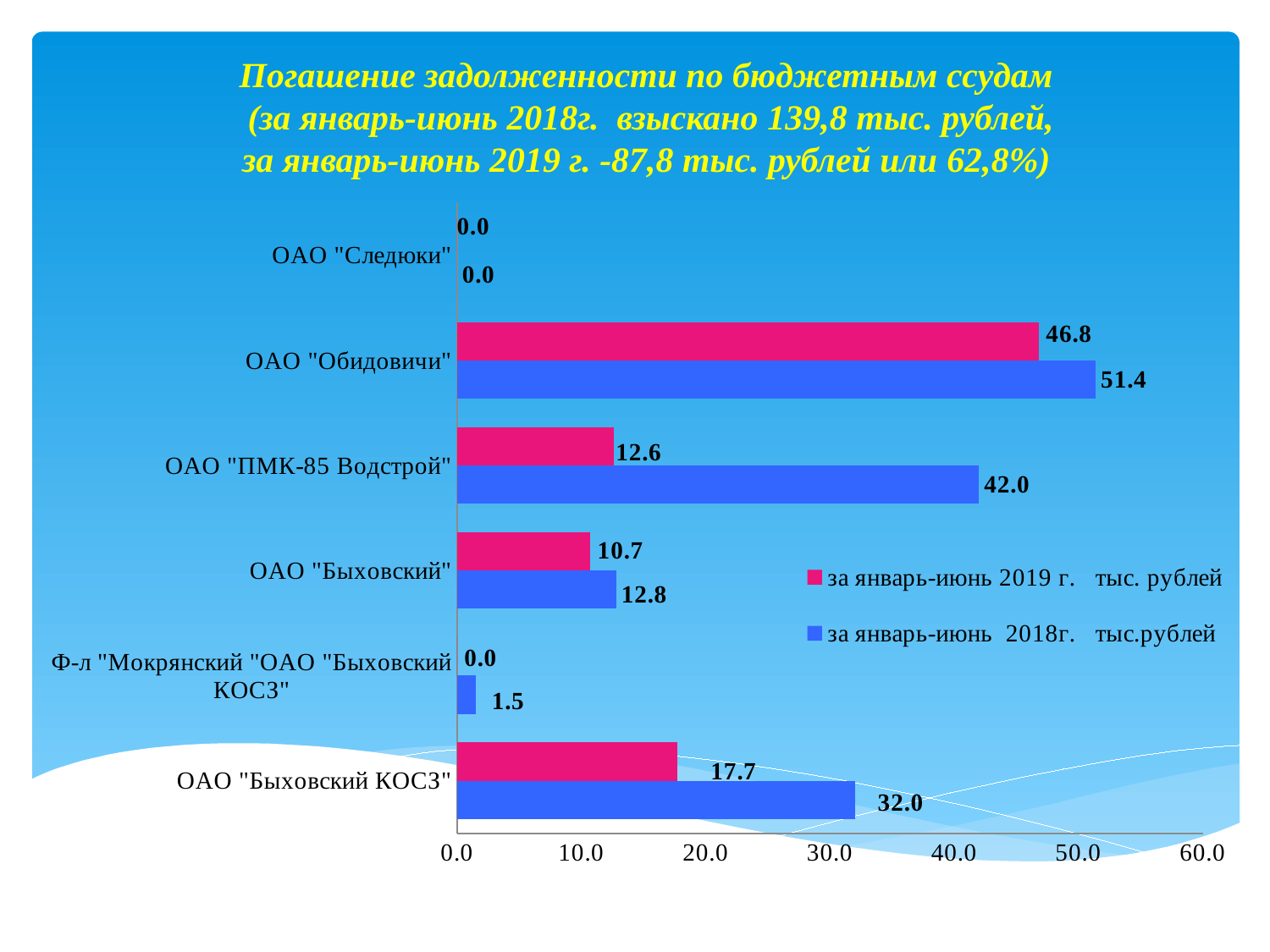
How many categories are shown on the chart? 6 Which category has the highest value in the series за январь-июнь 2019 г.? ОАО "Обидовичи" What is the value for ОАО "ПМК-85 Водстрой" in the series за январь-июнь 2018г.? 42.0 Which category has the highest value in the series за январь-июнь 2018г.? ОАО "Обидовичи" For ОАО "Быховский", which series has the larger value: за январь-июнь 2019 г. or за январь-июнь 2018г.? за январь-июнь 2018г. What is the difference between the 2018 and 2019 values for ОАО "Быховский КОСЗ"? 14.3 What is the value for ОАО "Обидовичи" in the series за январь-июнь 2019 г.? 46.8 What is the value for ОАО "Быховский КОСЗ" in the series за январь-июнь 2019 г.? 17.7 How many series does the legend list? 2 What is the value for Ф-л "Мокрянский" ОАО "Быховский КОСЗ" in the series за январь-июнь 2018г.? 1.5 What is the difference between the 2018 and 2019 values for ОАО "ПМК-85 Водстрой"? 29.4 What kind of chart is shown on the slide? bar chart